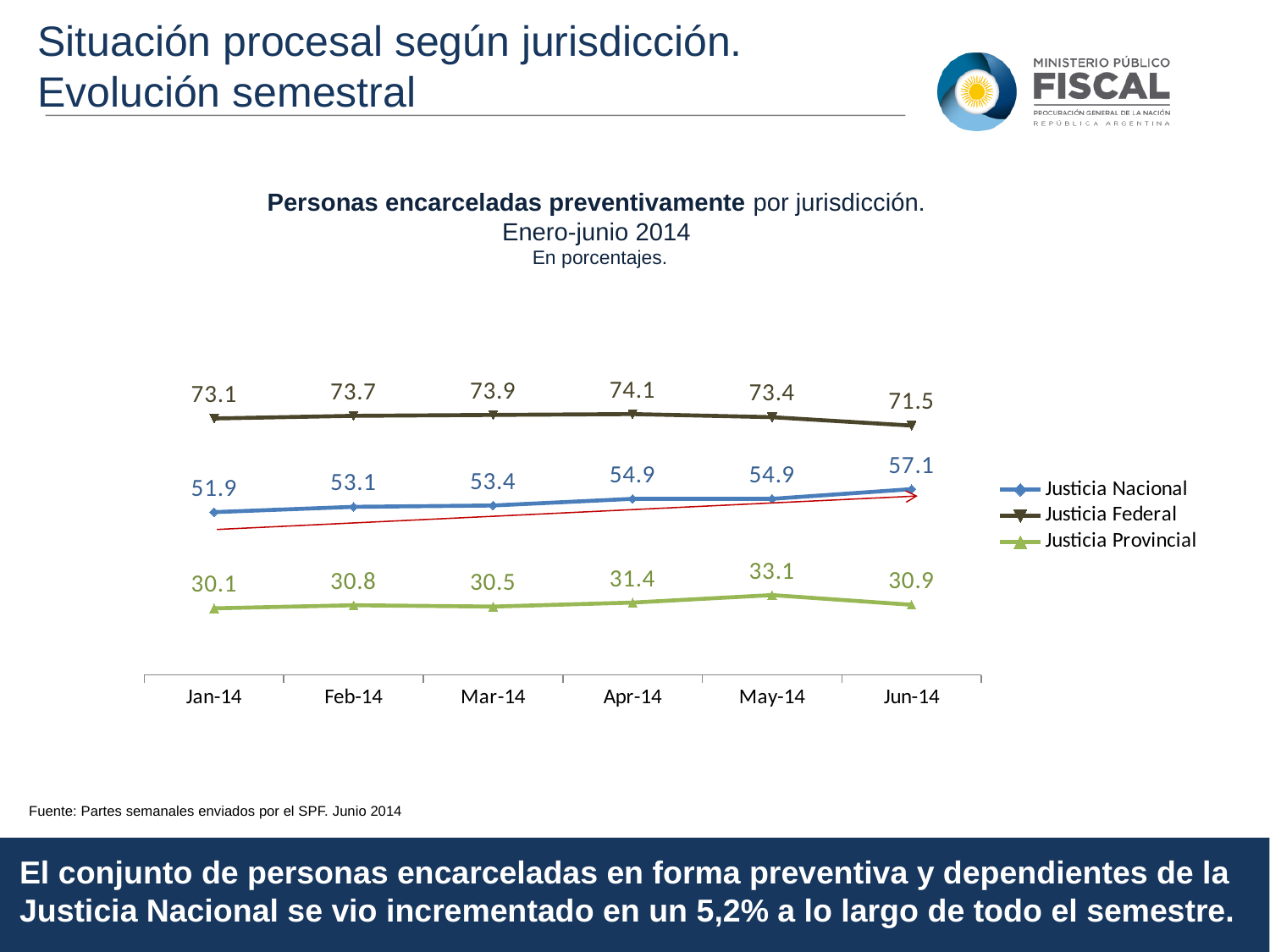
What is the value for Justicia Nacional in Jun-14? 57.1 What is the difference between the Justicia Nacional values in Jun-14 and Jan-14? 5.2 What kind of chart is shown on the slide? Line chart How many series does the legend list? 3 In which month does Justicia Federal reach its highest value? Apr-14 Does the Justicia Nacional series rise or fall from Jan-14 to Jun-14? Rise Which series is shown in green in the legend? Justicia Provincial Which is larger in Jun-14: Justicia Federal or Justicia Nacional? Justicia Federal What is the value for Justicia Federal in Apr-14? 74.1 What is the value for Justicia Provincial in May-14? 33.1 How many months are shown on the x axis? 6 In which month is the value for Justicia Provincial lowest? Jan-14